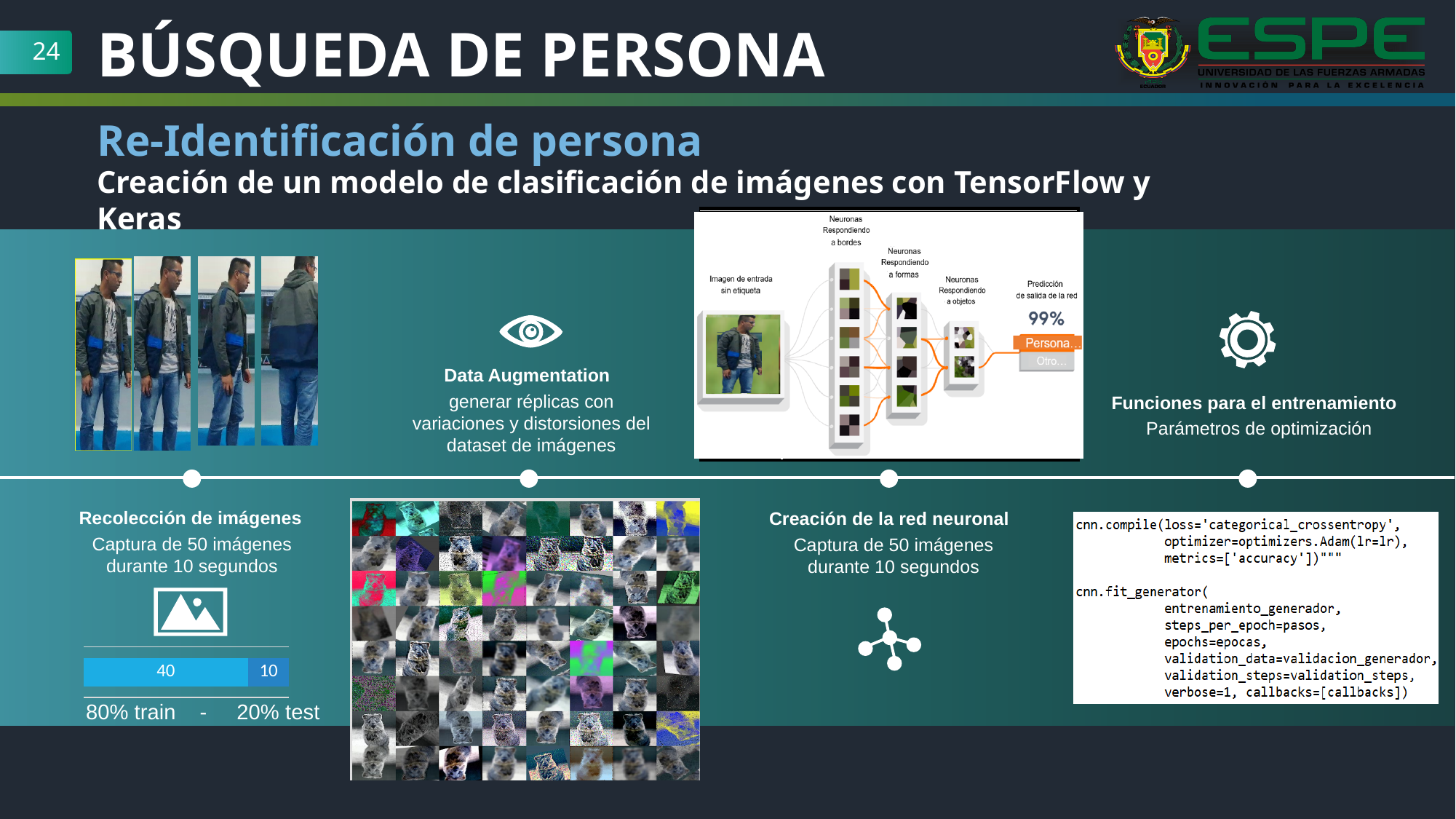
In the stacked bar chart under 'Recolección de imágenes', which segment has the lowest value? test (10) In the stacked bar chart under 'Recolección de imágenes', what percentage share is labelled for the test portion? 20% In the stacked bar chart under 'Recolección de imágenes', what value is printed on the larger (left) segment? 40 In the stacked bar chart under 'Recolección de imágenes', what is the total of the two segments? 50 In the stacked bar chart under 'Recolección de imágenes', what value is printed on the smaller (right) segment? 10 In the stacked bar chart under 'Recolección de imágenes', which segment is larger, the train segment or the test segment? train In the stacked bar chart under 'Recolección de imágenes', what is the difference between the two segment values? 30 In the stacked bar chart under 'Recolección de imágenes', is the value of the larger segment greater or less than 30? greater How many segments does the stacked bar under 'Recolección de imágenes' have? 2 In the stacked bar chart under 'Recolección de imágenes', what percentage share is labelled for the train portion? 80% What kind of chart is shown under 'Recolección de imágenes'? bar chart